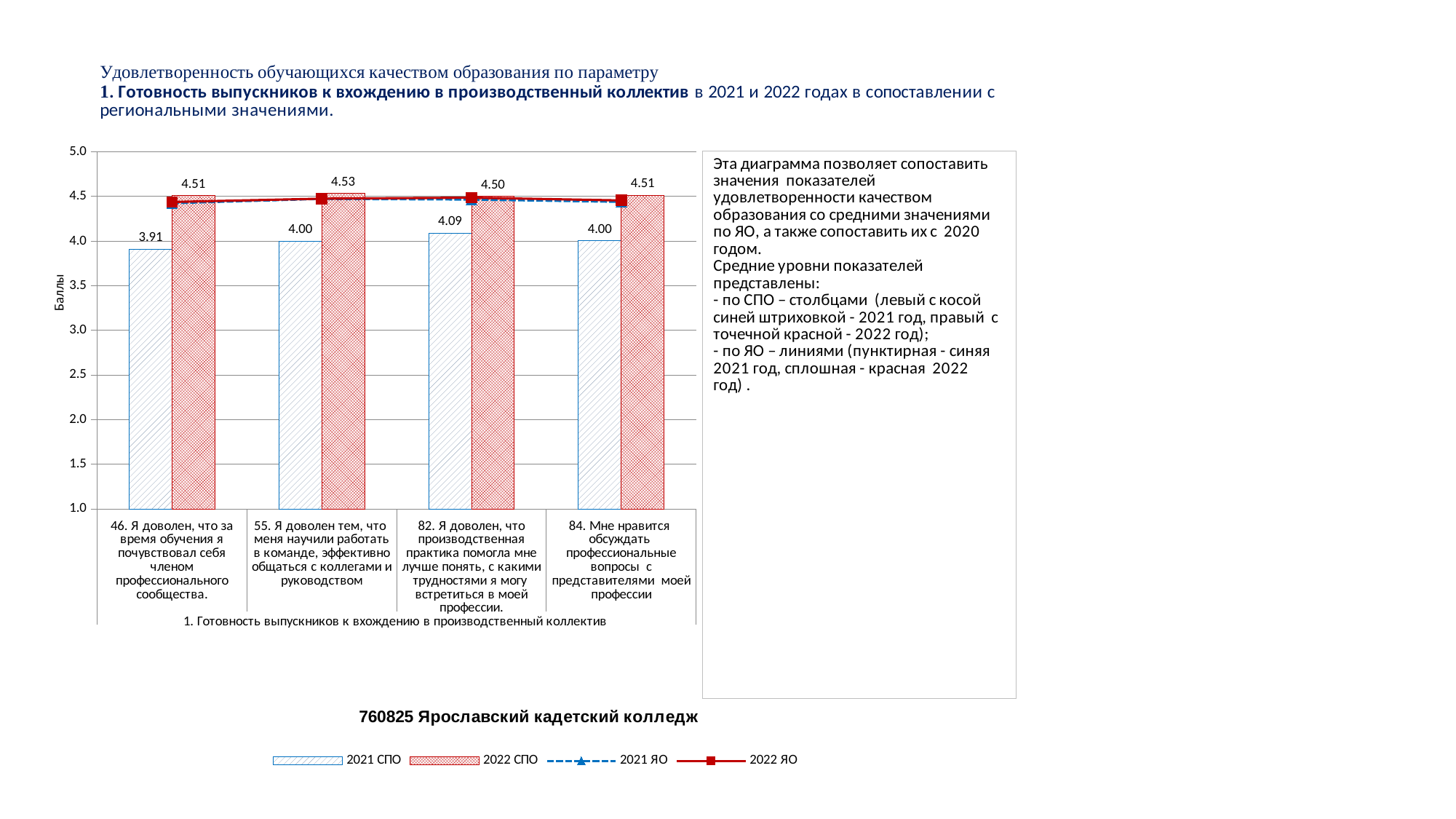
What is the value of the 2021 СПО bar for category 82 (производственная практика помогла мне лучше понять...)? 4.09 Is the 2021 ЯО line value for category 46 greater or less than 4.0? greater How many series does the legend list? 4 What is the value of the 2021 СПО bar for category 46 (Я доволен, что за время обучения я почувствовал себя членом профессионального сообщества)? 3.91 How many categories are shown on the x axis of the chart? 4 What is the value of the 2022 СПО bar for category 55 (Я доволен тем, что меня научили работать в команде)? 4.53 What is the value of the 2022 СПО bar for category 84 (Мне нравится обсуждать профессиональные вопросы...)? 4.51 Which category has the highest 2022 СПО value? 55. Я доволен тем, что меня научили работать в команде, эффективно общаться с коллегами и руководством What is the difference between the 2022 СПО and 2021 СПО values for category 46? 0.60 Which category has the lowest 2021 СПО value? 46. Я доволен, что за время обучения я почувствовал себя членом профессионального сообщества. What is the title of the vertical axis of the chart? Баллы Which is larger: the 2021 СПО value for category 82 or for category 84? Category 82 (4.09)